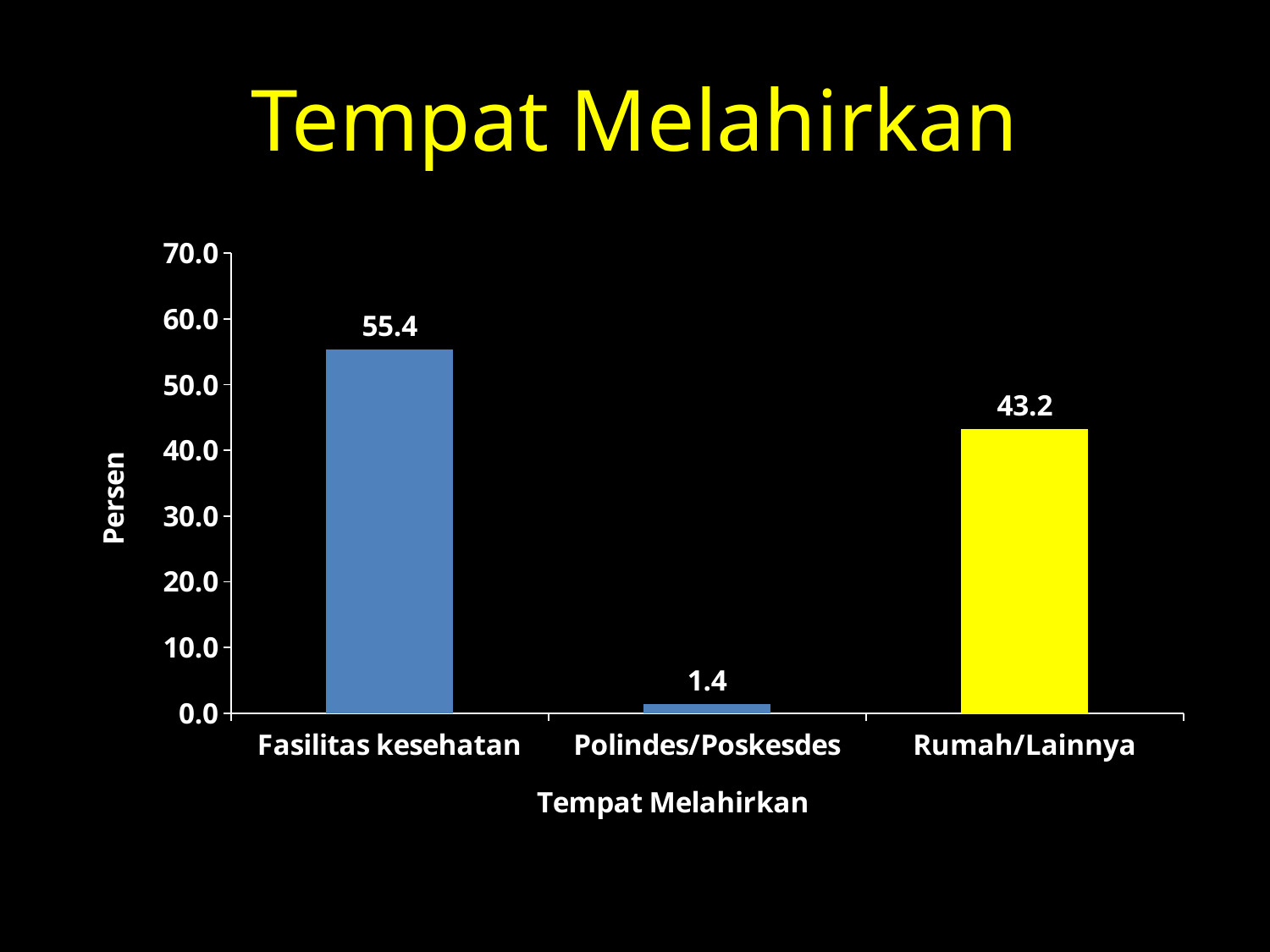
Which category has the lowest value? Polindes/Poskesdes What is the title of the chart? Tempat Melahirkan What is the label of the y axis? Persen What is the value for Rumah/Lainnya? 43.2 What is the value for Polindes/Poskesdes? 1.4 What kind of chart is shown on the slide? bar chart What is the difference between the values for Fasilitas kesehatan and Rumah/Lainnya? 12.2 What is the value for Fasilitas kesehatan? 55.4 Which category has the highest value? Fasilitas kesehatan Is the value for Rumah/Lainnya greater or less than 50.0? less Which is larger, the value for Rumah/Lainnya or the value for Polindes/Poskesdes? Rumah/Lainnya How many categories are shown on the x axis? 3